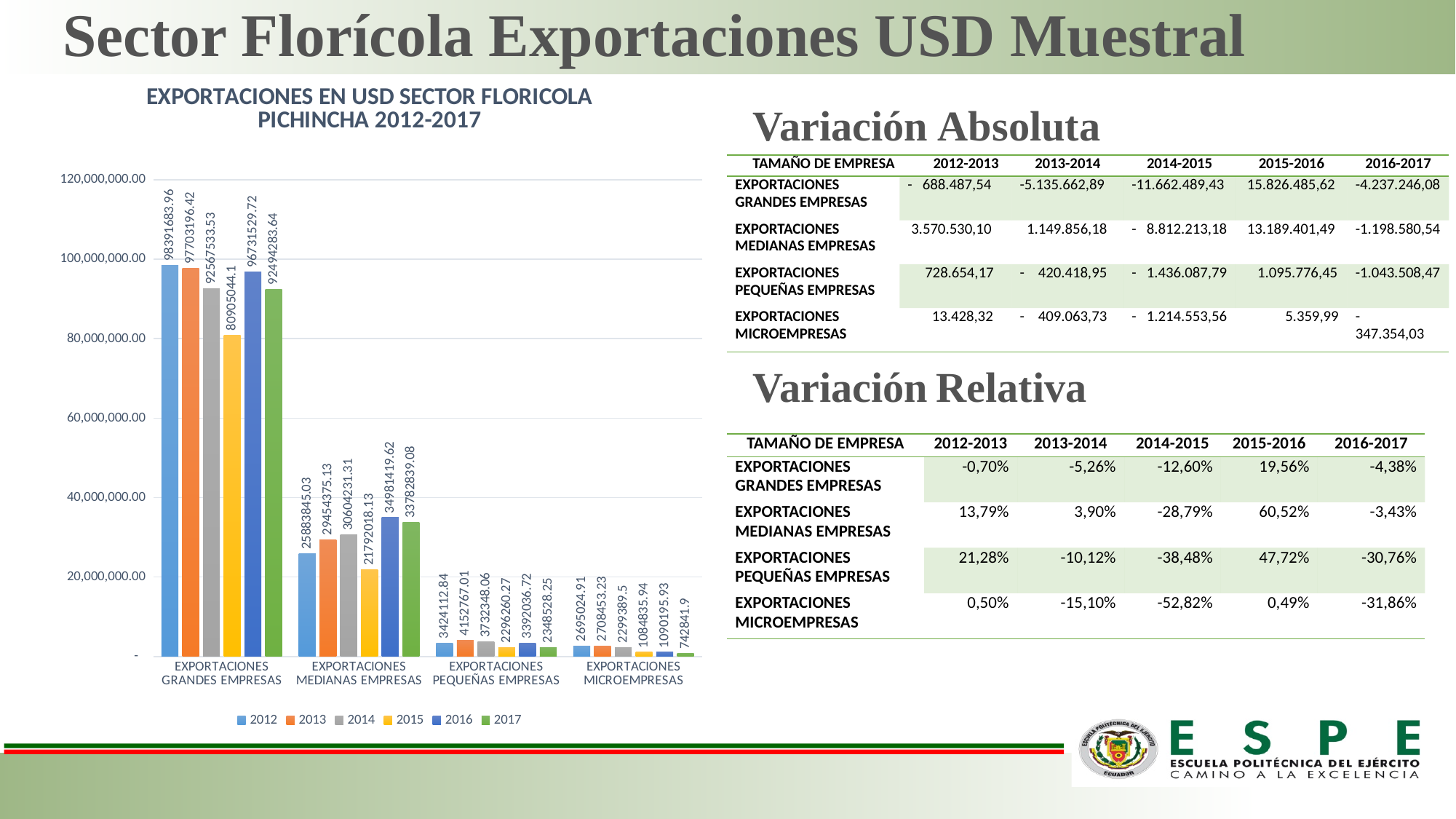
Which year has the highest value for EXPORTACIONES MEDIANAS EMPRESAS? 2016 How many company-size categories are shown on the x axis of the chart? 4 Is the value for EXPORTACIONES MEDIANAS EMPRESAS in 2016 greater or less than 40,000,000.00? less What is the value for EXPORTACIONES GRANDES EMPRESAS in 2012? 98391683.96 Which year has the lowest value for EXPORTACIONES GRANDES EMPRESAS? 2015 What is the value for EXPORTACIONES MEDIANAS EMPRESAS in 2016? 34981419.62 What is the title of the chart? EXPORTACIONES EN USD SECTOR FLORICOLA PICHINCHA 2012-2017 How many series does the legend of the chart list? 6 What type of chart is shown on the slide? Bar chart Which is larger for EXPORTACIONES PEQUEÑAS EMPRESAS: the 2013 value or the 2015 value? 2013 What is the value for EXPORTACIONES MICROEMPRESAS in 2017? 742841.9 What is the difference between the 2012 and 2013 values for EXPORTACIONES GRANDES EMPRESAS? 688487.54